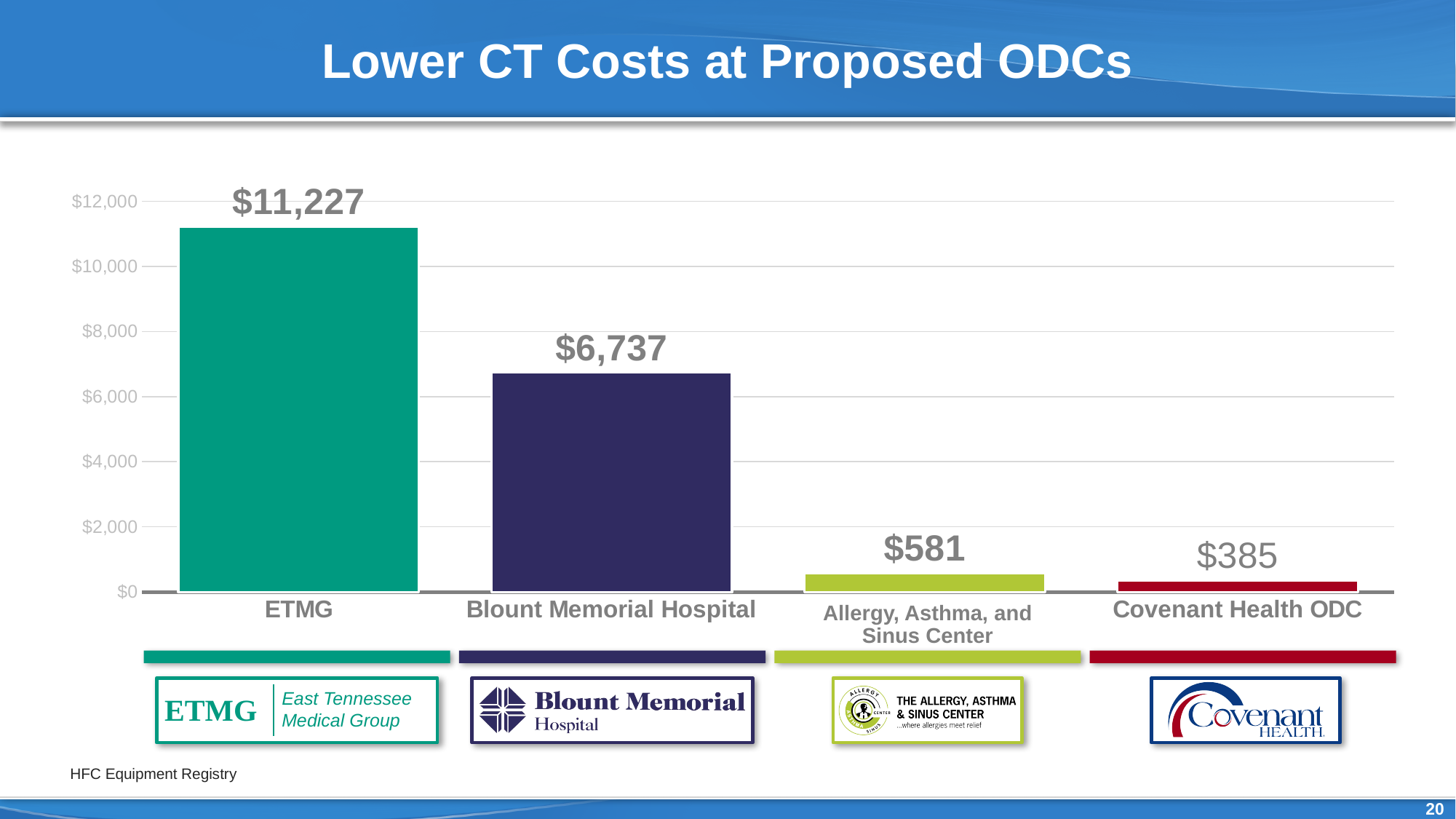
What is the CT cost shown for Allergy, Asthma, and Sinus Center? $581 Which has a higher CT cost, Blount Memorial Hospital or Allergy, Asthma, and Sinus Center? Blount Memorial Hospital What is the CT cost shown for Blount Memorial Hospital? $6,737 What is the title of the slide? Lower CT Costs at Proposed ODCs How many providers are shown in the chart? 4 Which provider has the lowest CT cost? Covenant Health ODC What is the difference between the CT cost at ETMG and at Blount Memorial Hospital? $4,490 What is the CT cost shown for Covenant Health ODC? $385 What is the CT cost shown for ETMG? $11,227 What kind of chart is shown on the slide? Bar chart What is the difference between the CT cost at Allergy, Asthma, and Sinus Center and at Covenant Health ODC? $196 Which provider has the highest CT cost? ETMG